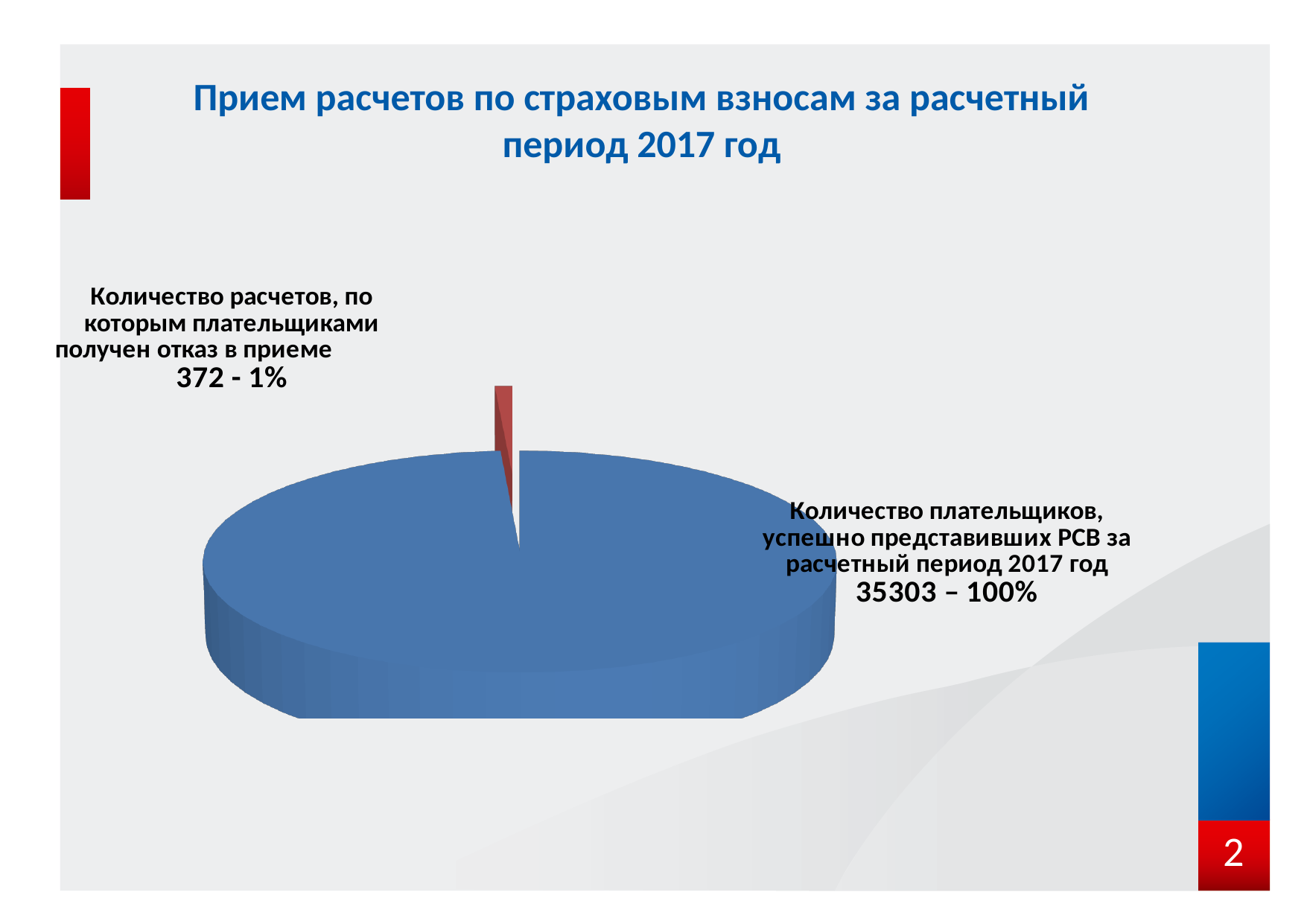
What is the value for "Количество плательщиков, успешно представивших РСВ за расчетный период 2017 год"? 35303 What percentage is shown for the slice "Количество плательщиков, успешно представивших РСВ за расчетный период 2017 год"? 100% What is the difference between the value for payers who successfully submitted РСВ (35303) and the number of rejected calculations (372)? 34931 What type of chart is shown on the slide? pie chart Which slice of the pie chart is the smallest? Количество расчетов, по которым плательщиками получен отказ в приеме What is the title of the chart on the slide? Прием расчетов по страховым взносам за расчетный период 2017 год Which slice of the pie chart is the largest? Количество плательщиков, успешно представивших РСВ за расчетный период 2017 год What colour is the slice for "Количество расчетов, по которым плательщиками получен отказ в приеме"? red How many slices does the pie chart have? 2 What percentage is shown for the slice "Количество расчетов, по которым плательщиками получен отказ в приеме"? 1% What is the value for "Количество расчетов, по которым плательщиками получен отказ в приеме"? 372 Which is larger: the number of rejected calculations or the number of payers who successfully submitted РСВ? Количество плательщиков, успешно представивших РСВ за расчетный период 2017 год